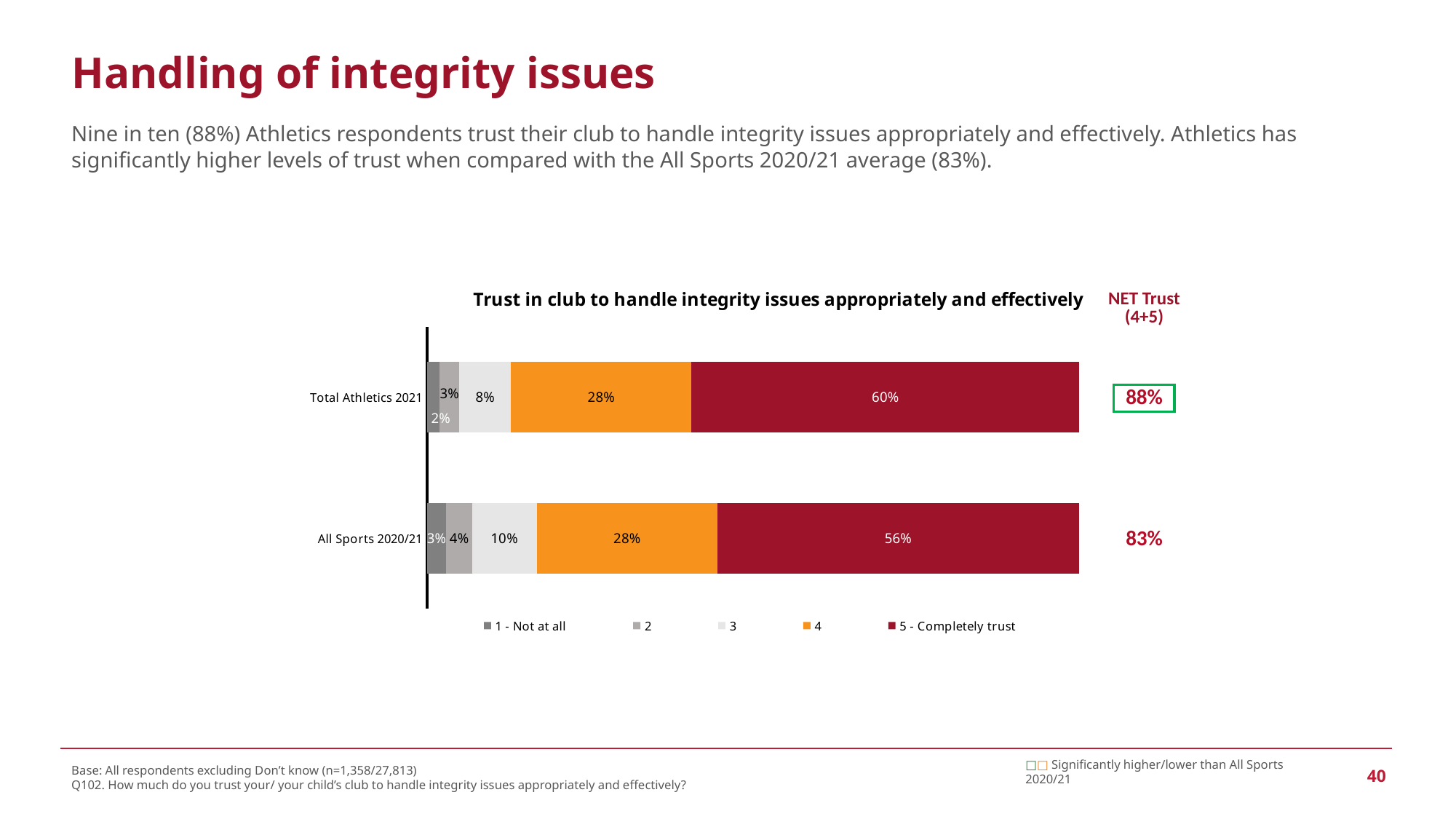
What percentage of All Sports 2020/21 respondents gave a rating of 3? 10% How many series does the legend list? 5 What is the difference in the 5 - Completely trust share between Total Athletics 2021 and All Sports 2020/21? 4 percentage points Which rating segment is shown in orange in the chart? 4 What is the value for rating 2 in the Total Athletics 2021 bar? 3% What kind of chart is shown on the slide? Stacked bar chart What is the difference between the NET Trust figures for Total Athletics 2021 and All Sports 2020/21? 5 percentage points What is the title of the chart? Trust in club to handle integrity issues appropriately and effectively What percentage of Total Athletics 2021 respondents gave a rating of 5 - Completely trust? 60% What is the NET Trust (4+5) figure shown for All Sports 2020/21? 83% How many categories (bars) are shown in the chart? 2 Which category has the higher share of 5 - Completely trust, Total Athletics 2021 or All Sports 2020/21? Total Athletics 2021